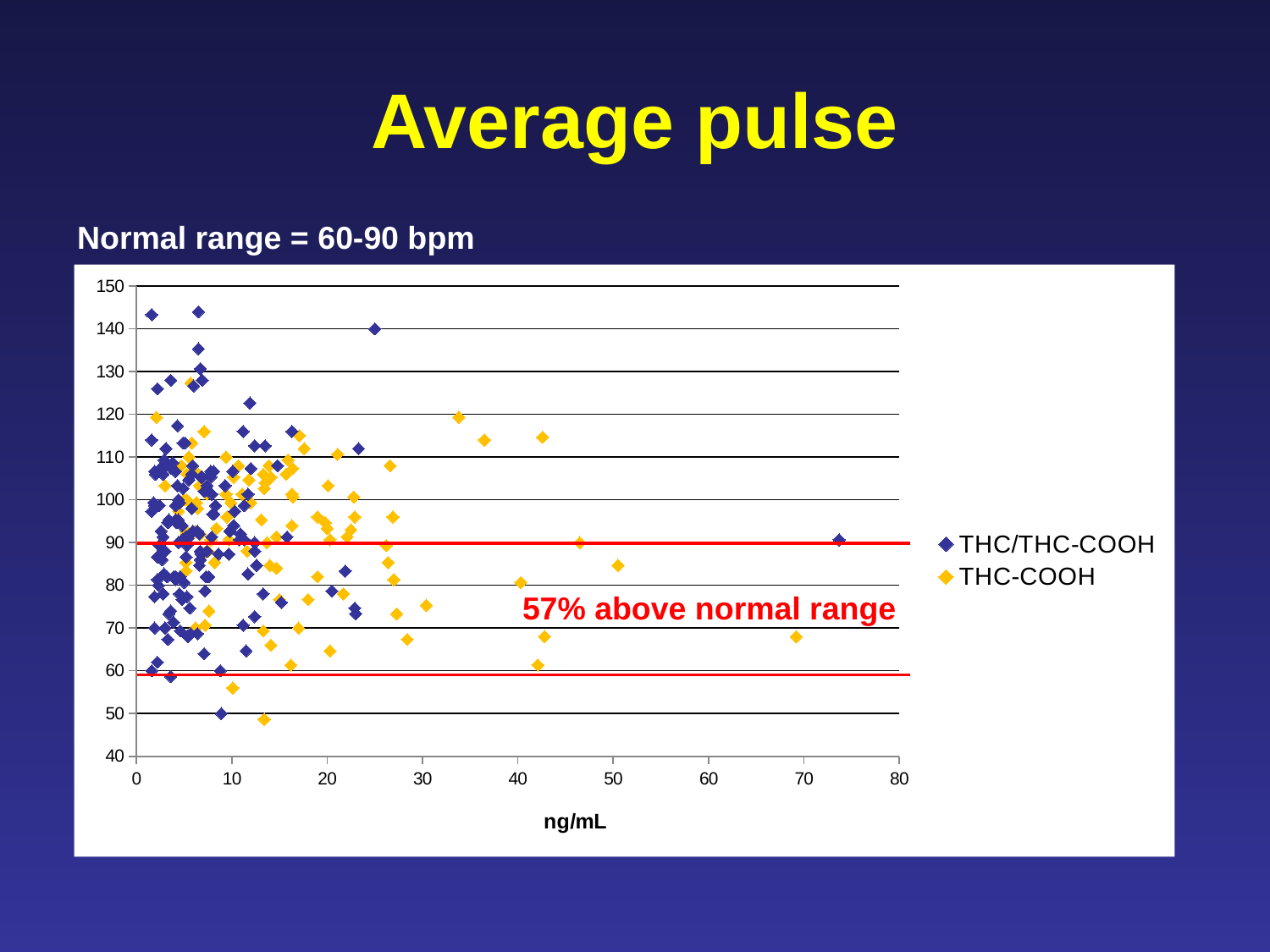
Which series has the point with the lowest pulse value on the chart? THC-COOH What are the two series named in the legend? THC/THC-COOH and THC-COOH Is the x value of the rightmost THC-COOH point greater or less than 60? greater What kind of chart is shown on the slide? scatter chart How many series does the legend list? 2 Which series has the point with the highest pulse value on the chart? THC/THC-COOH Is the highest THC-COOH point greater or less than 130? less Is the lowest THC/THC-COOH point greater or less than 60? less What is the label on the x axis? ng/mL